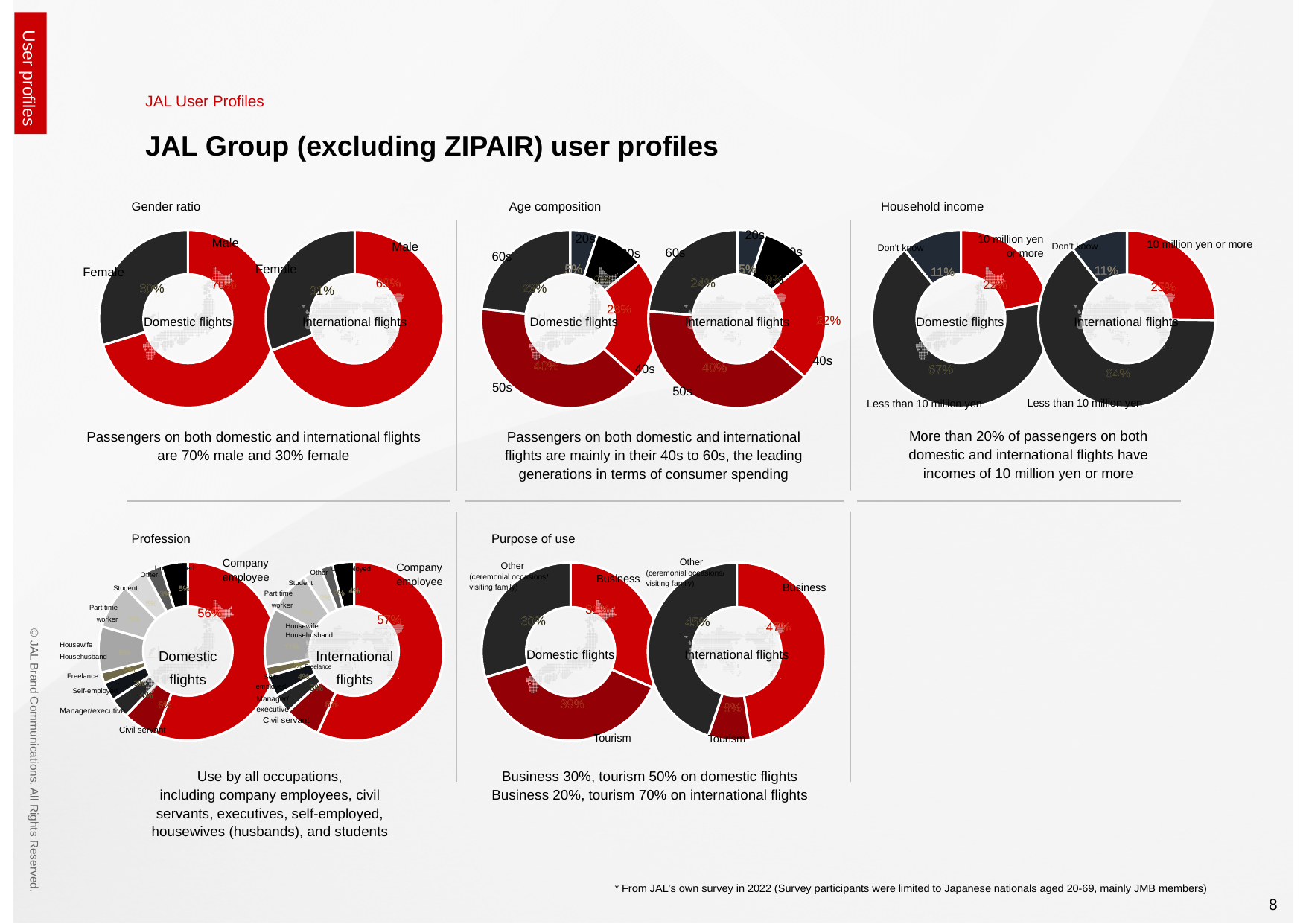
In the Gender ratio chart for Domestic flights, what is the difference between the male and female shares? 40% In the Household income chart for Domestic flights, what share of passengers answered 'Don't know'? 11% In the Gender ratio chart for International flights, what percentage of passengers are male? 69% In the Household income chart for Domestic flights, what share of passengers have incomes of less than 10 million yen? 67% In the Household income chart for International flights, what share of passengers have incomes of 10 million yen or more? 25% How many categories does each Household income chart show? 3 In the Gender ratio chart for Domestic flights, what percentage of passengers are female? 30% What kind of chart is used for the Gender ratio? Doughnut chart In the Age composition chart for Domestic flights, which age group has the largest share? 50s In the Gender ratio chart for Domestic flights, what percentage of passengers are male? 70% In the Household income chart for International flights, which is larger: the share with less than 10 million yen or the share with 10 million yen or more? Less than 10 million yen In the Age composition chart for International flights, what share of passengers are in their 50s? 40%